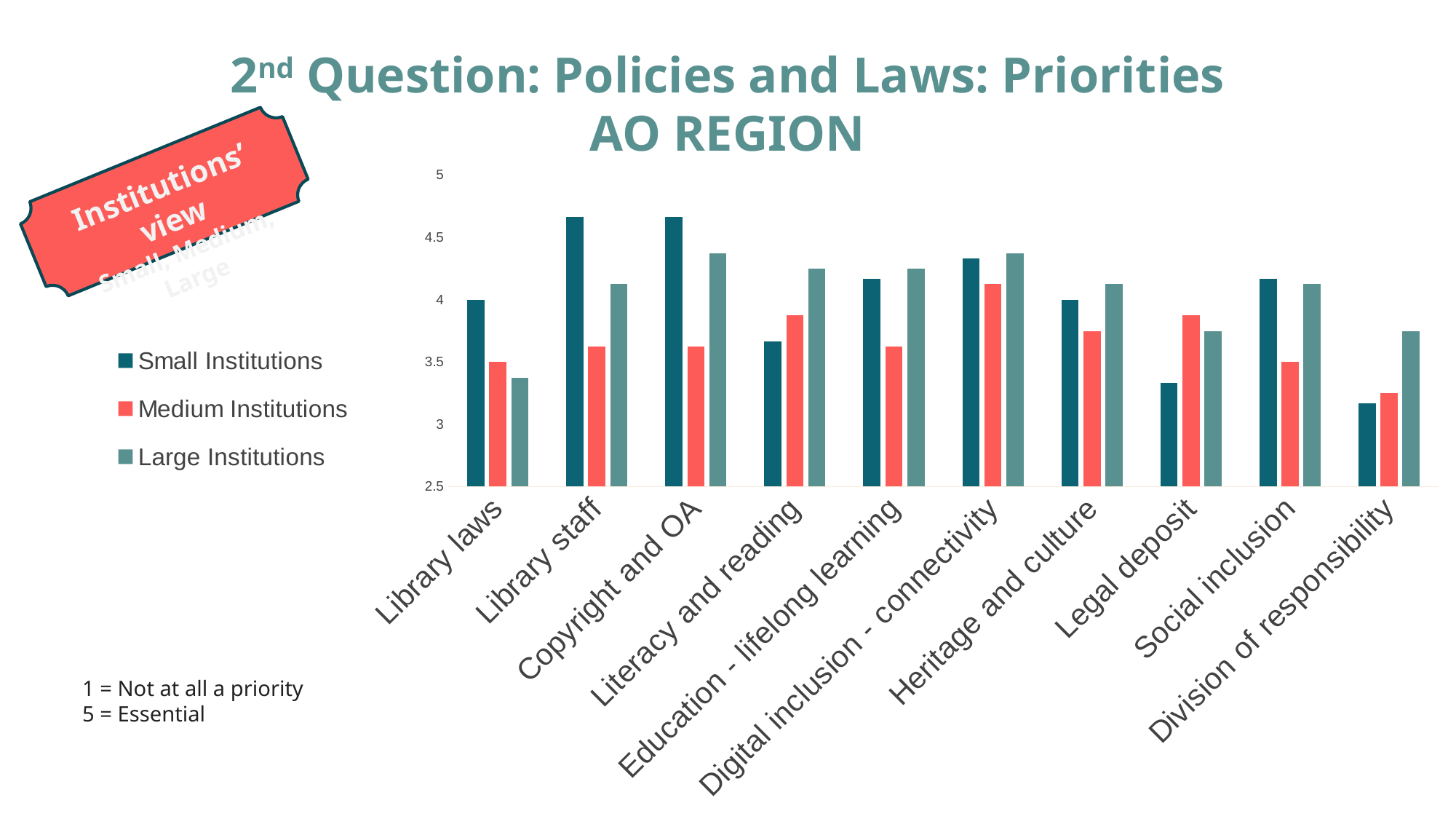
What kind of chart is shown on the slide? bar chart How many series does the legend list? 3 How many categories are shown along the x axis? 10 For Large Institutions, which category has the lowest value? Library laws For Medium Institutions, which category has the highest value? Digital inclusion - connectivity What colour represents Medium Institutions in the legend? red For Small Institutions, which category has the lowest value? Division of responsibility For Library laws, which is larger: the Small Institutions value or the Large Institutions value? Small Institutions What is the lowest value shown on the y axis? 2.5 Is the Small Institutions value for Library staff greater or less than 4.5? greater Is the Medium Institutions value for Division of responsibility greater or less than 3.5? less For Legal deposit, which is larger: the Small Institutions value or the Medium Institutions value? Medium Institutions